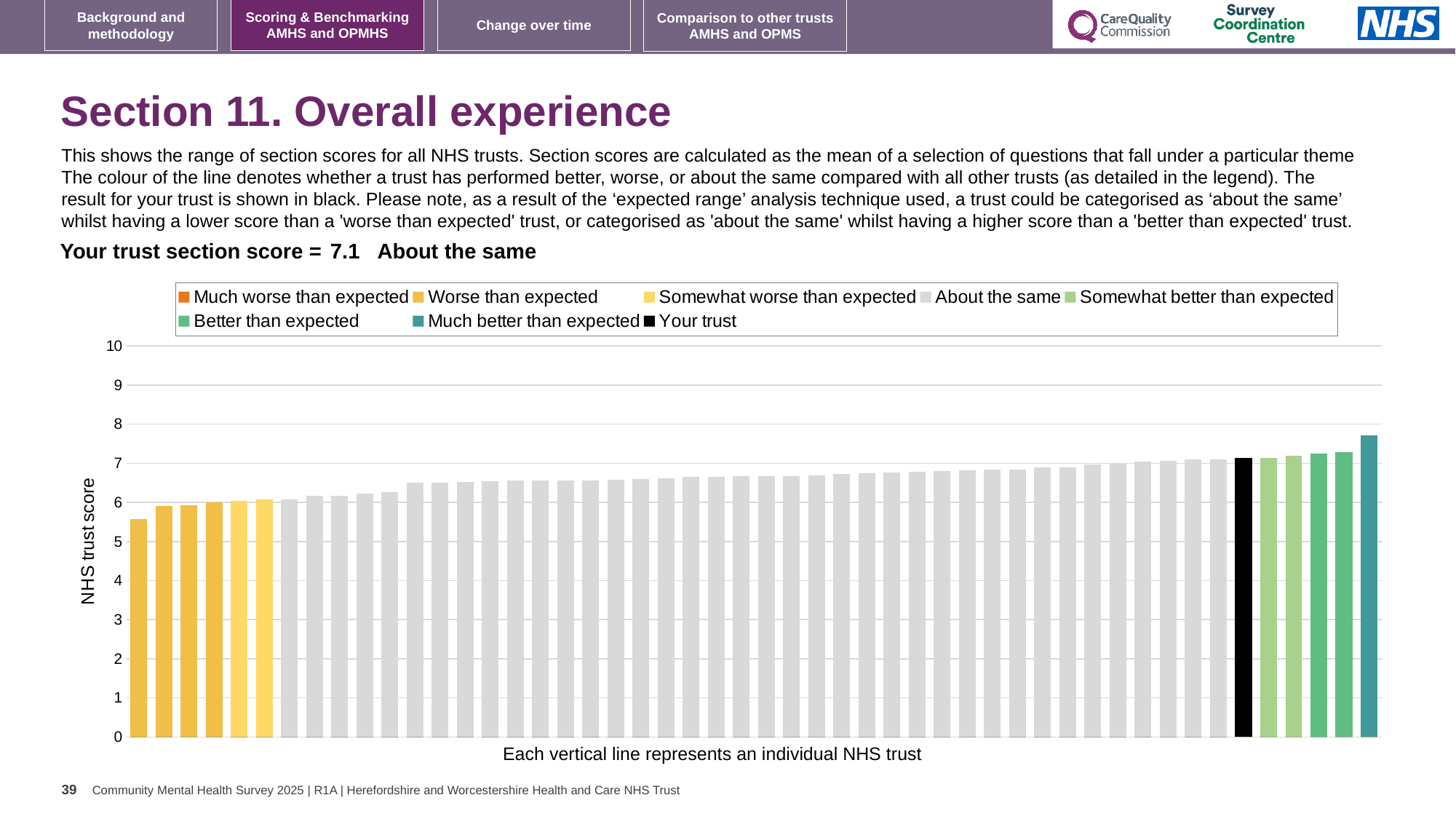
Is the value for the lowest-scoring trust (leftmost bar) greater or less than 6? less Which benchmarking category is your trust placed in? About the same Do the trust scores rise or fall moving from left to right along the x axis? Rise What is the label on the vertical axis of the chart? NHS trust score Is the value for your trust greater or less than 7? greater Is the value for the highest-scoring trust (rightmost bar) greater or less than 7? greater What is the section score for your trust? 7.1 How many entries does the chart legend list? 8 Which legend category does the highest bar on the chart belong to? Much better than expected What kind of chart is shown on the slide? Bar chart What colour is the bar representing your trust? Black